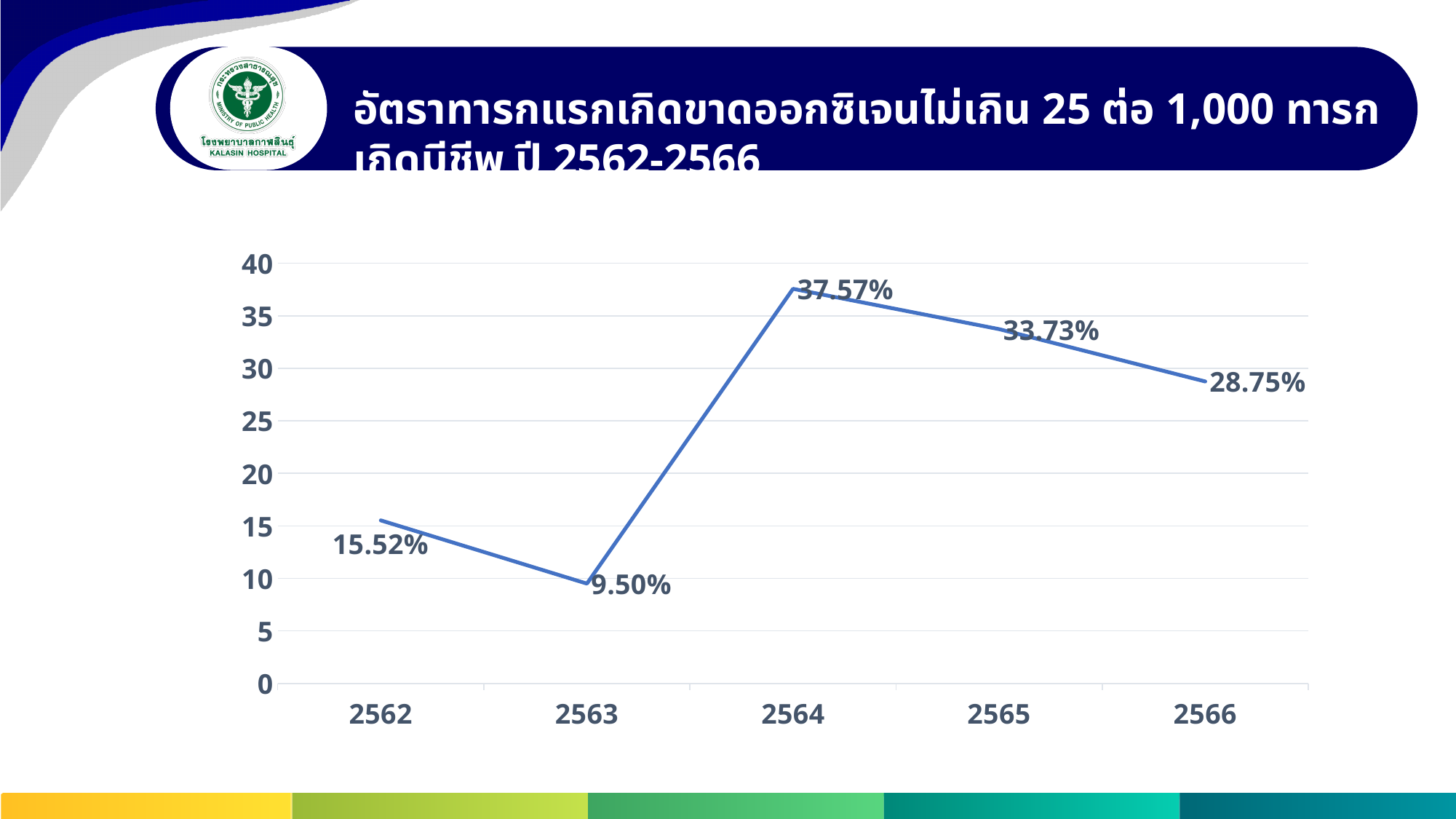
What is the value for 2564? 37.57% Which is larger, the value for 2565 or the value for 2566? 2565 Which year has the highest value? 2564 What is the value for 2563? 9.50% What is the value for 2565? 33.73% Which year has the lowest value? 2563 Do the values rise or fall from 2564 to 2566? fall How many years are plotted on the x axis? 5 What kind of chart is shown on the slide? line chart What is the value for 2562? 15.52% What is the difference between the values for 2564 and 2563? 28.07% What is the value for 2566? 28.75%